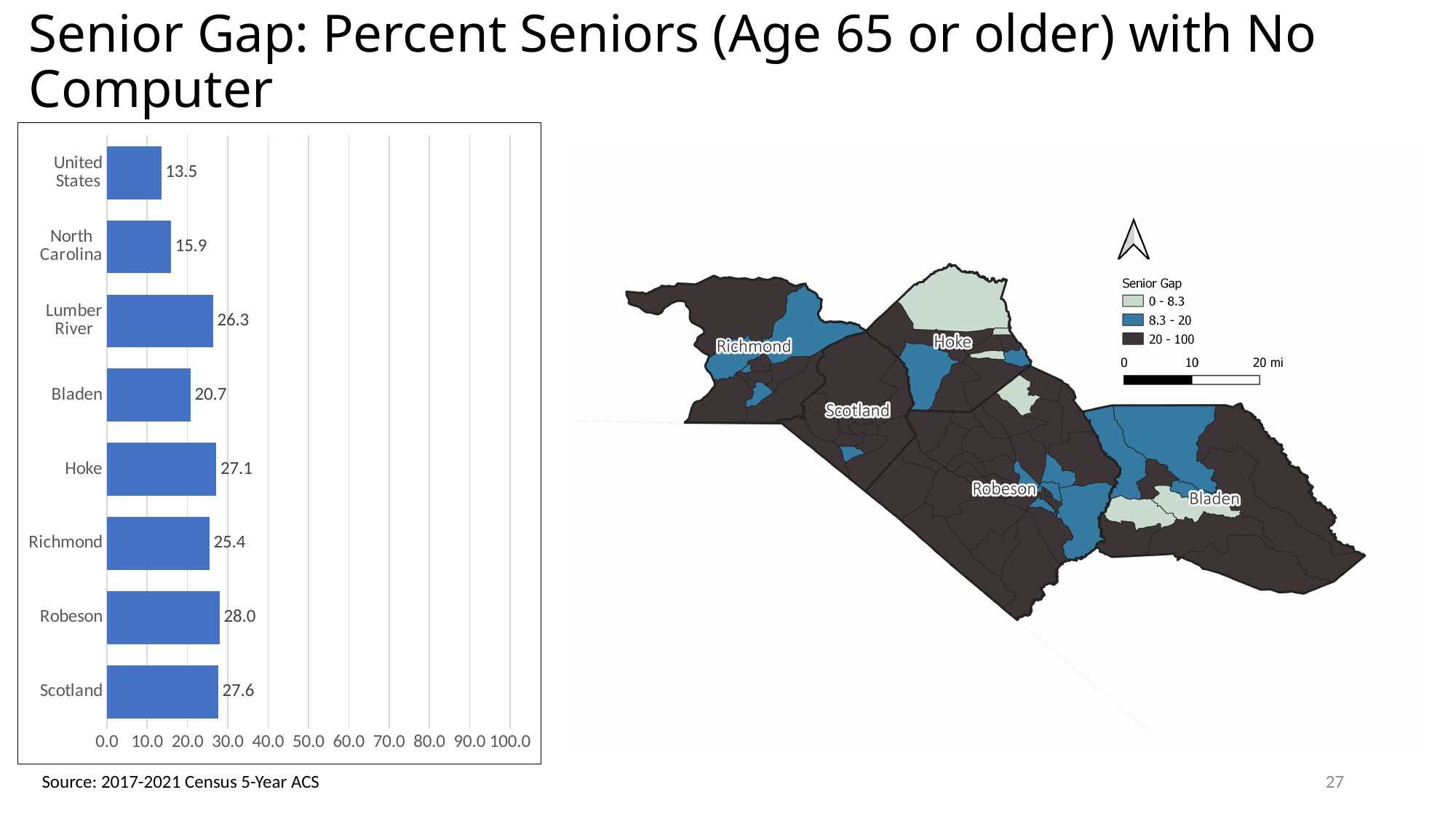
What kind of chart is shown on the left of the slide? Bar chart Which category has the highest value in the bar chart? Robeson What is the value for the United States in the bar chart? 13.5 Which has a larger value in the bar chart, Bladen or Richmond? Richmond Is the value for Scotland in the bar chart greater or less than 20.0? greater What is the value for Lumber River in the bar chart? 26.3 Which category has the lowest value in the bar chart? United States What is the difference between the values for Hoke and North Carolina in the bar chart? 11.2 What is the data source cited below the bar chart? 2017-2021 Census 5-Year ACS What is the value for Robeson in the bar chart? 28.0 What is the maximum value shown on the x axis of the bar chart? 100.0 How many categories are shown in the bar chart? 8